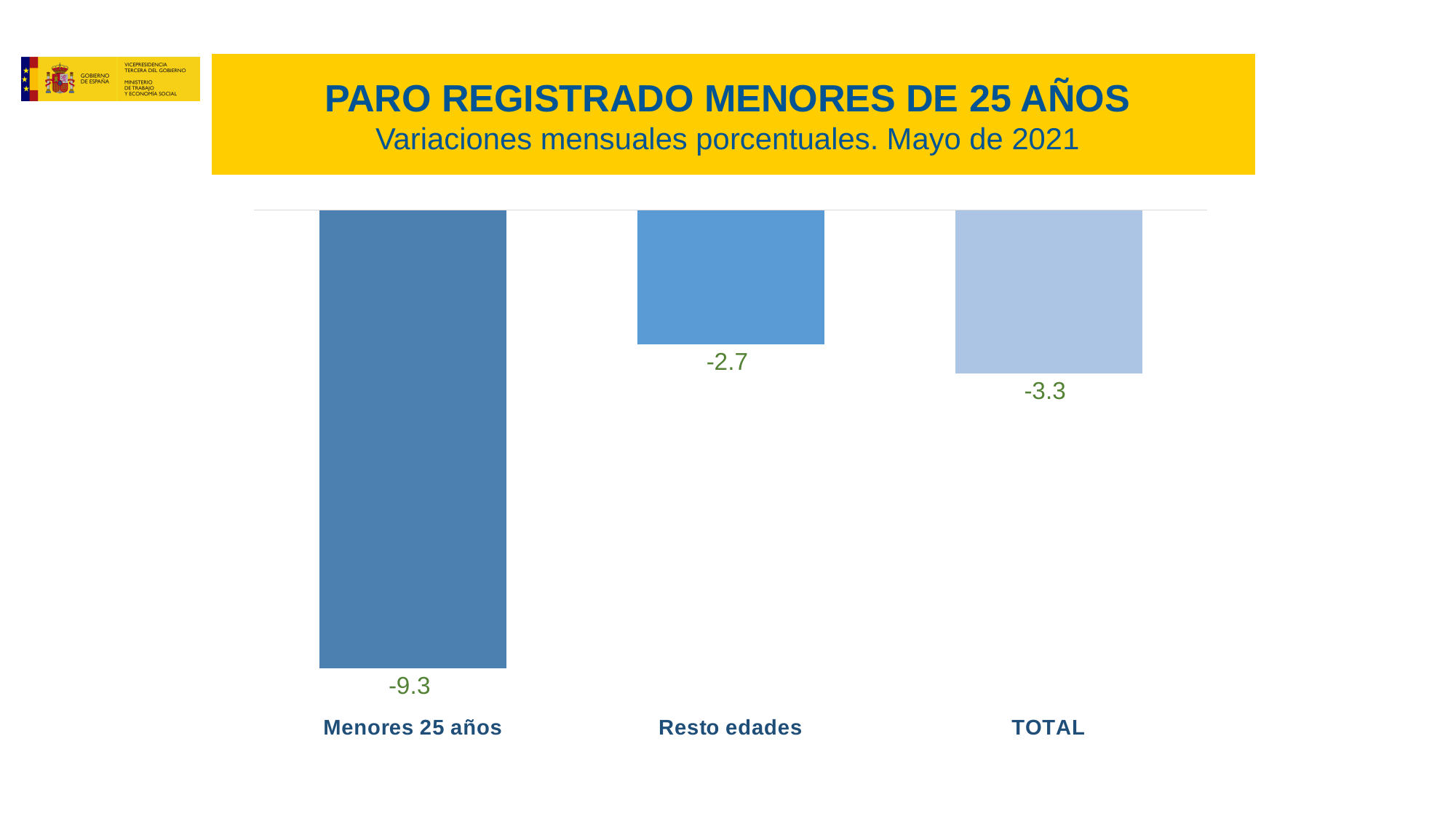
What kind of chart is shown on the slide? Bar chart Which category has the lowest value? Menores 25 años What is the value for Resto edades? -2.7 Which is larger, the value for Resto edades or the value for TOTAL? Resto edades Which category has the highest value? Resto edades What is the value for TOTAL? -3.3 What is the difference between the values for Menores 25 años and Resto edades? 6.6 How many categories are shown in the chart? 3 What is the title of the chart? PARO REGISTRADO MENORES DE 25 AÑOS What is the difference between the values for TOTAL and Resto edades? 0.6 Which month and year does the chart subtitle refer to? Mayo de 2021 What is the value for Menores 25 años? -9.3